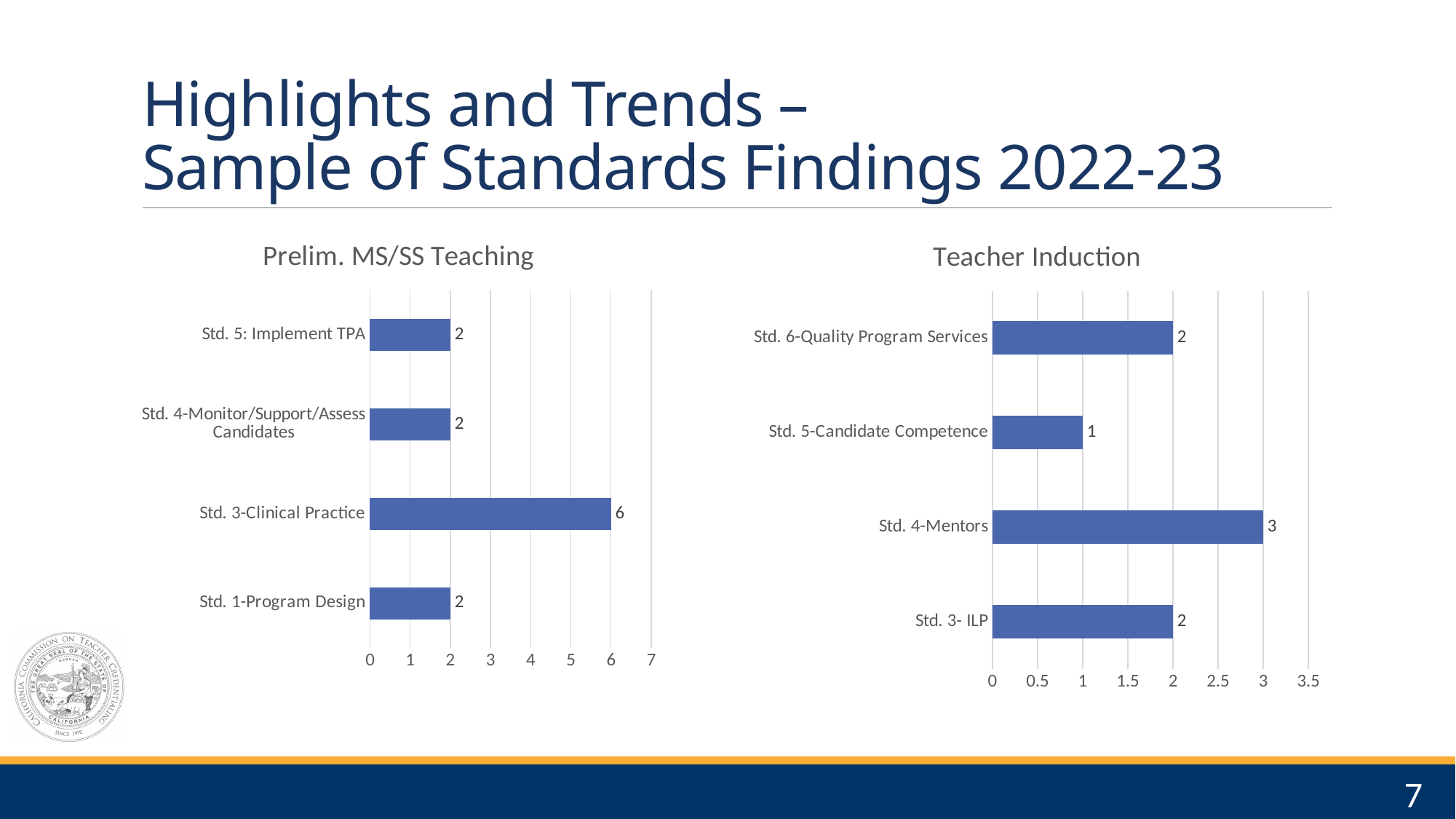
In the Teacher Induction chart, what is the difference between Std. 4-Mentors and Std. 3- ILP? 1 In the Prelim. MS/SS Teaching chart, what is the value for Std. 3-Clinical Practice? 6 In the Prelim. MS/SS Teaching chart, how many standards are plotted? 4 In the Teacher Induction chart, what is the value for Std. 5-Candidate Competence? 1 In the Prelim. MS/SS Teaching chart, what is the difference between Std. 3-Clinical Practice and Std. 5: Implement TPA? 4 What is the title of the chart on the right side of the slide? Teacher Induction In the Teacher Induction chart, which is larger: Std. 4-Mentors or Std. 6-Quality Program Services? Std. 4-Mentors What kind of chart is the Prelim. MS/SS Teaching chart? Bar chart In the Prelim. MS/SS Teaching chart, which standard has the highest value? Std. 3-Clinical Practice In the Teacher Induction chart, what is the value for Std. 4-Mentors? 3 In the Teacher Induction chart, which standard has the lowest value? Std. 5-Candidate Competence In the Prelim. MS/SS Teaching chart, what is the value for Std. 1-Program Design? 2